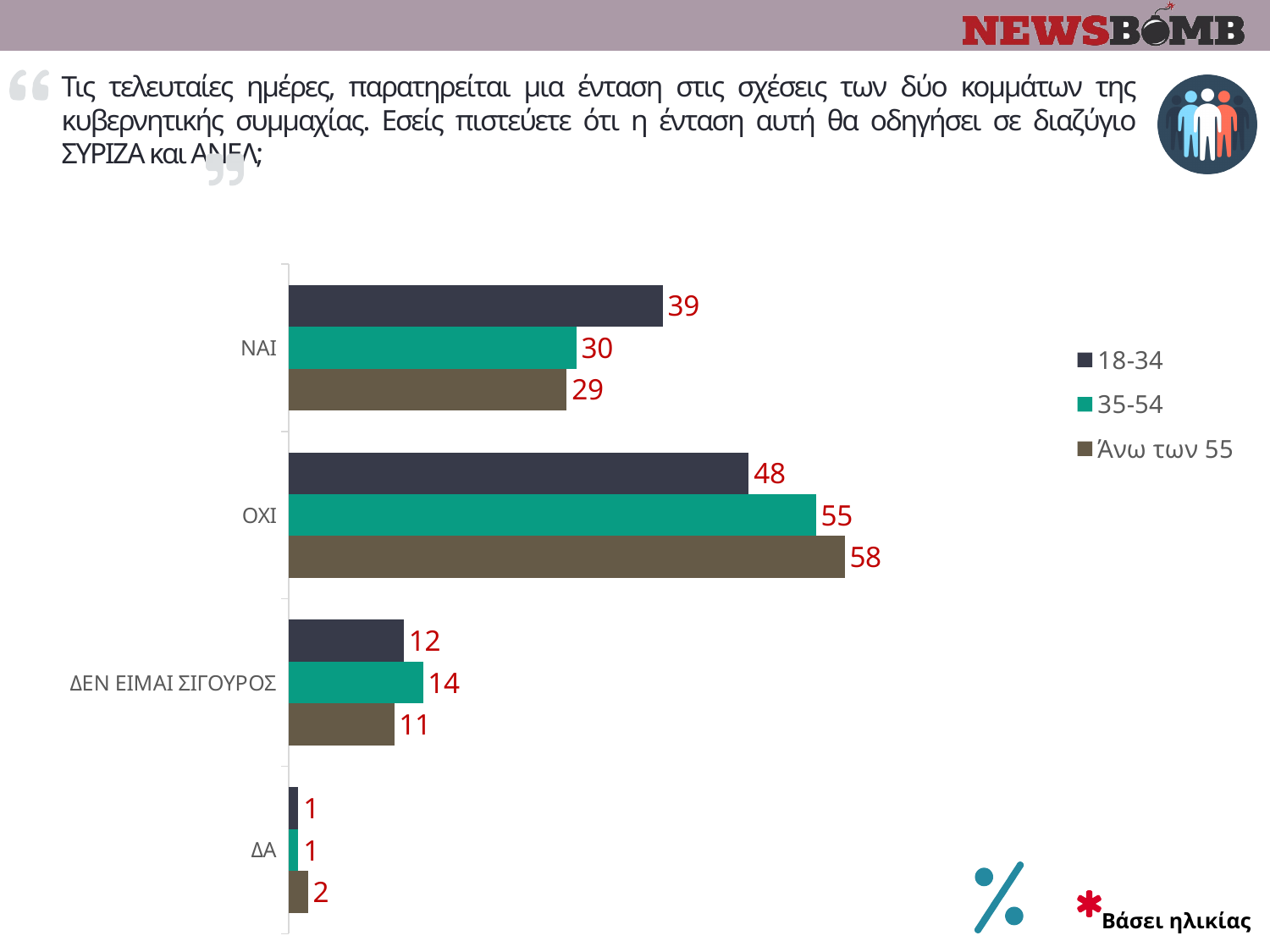
Which category has the lowest value for the 18-34 series? ΔΑ What is the value for the 18-34 series in the ΝΑΙ category? 39 What is the value for the Άνω των 55 series in the ΔΑ category? 2 What kind of chart is shown on the slide? bar chart How many series does the legend list? 3 How many categories are shown on the chart? 4 What is the value for the 35-54 series in the ΔΕΝ ΕΙΜΑΙ ΣΙΓΟΥΡΟΣ category? 14 What is the value for the Άνω των 55 series in the ΟΧΙ category? 58 Which category has the highest value for the 35-54 series? ΟΧΙ In the ΝΑΙ category, which series has the larger value: 18-34 or 35-54? 18-34 Which series is shown in green in the legend? 35-54 What is the difference between the Άνω των 55 and 18-34 values in the ΟΧΙ category? 10